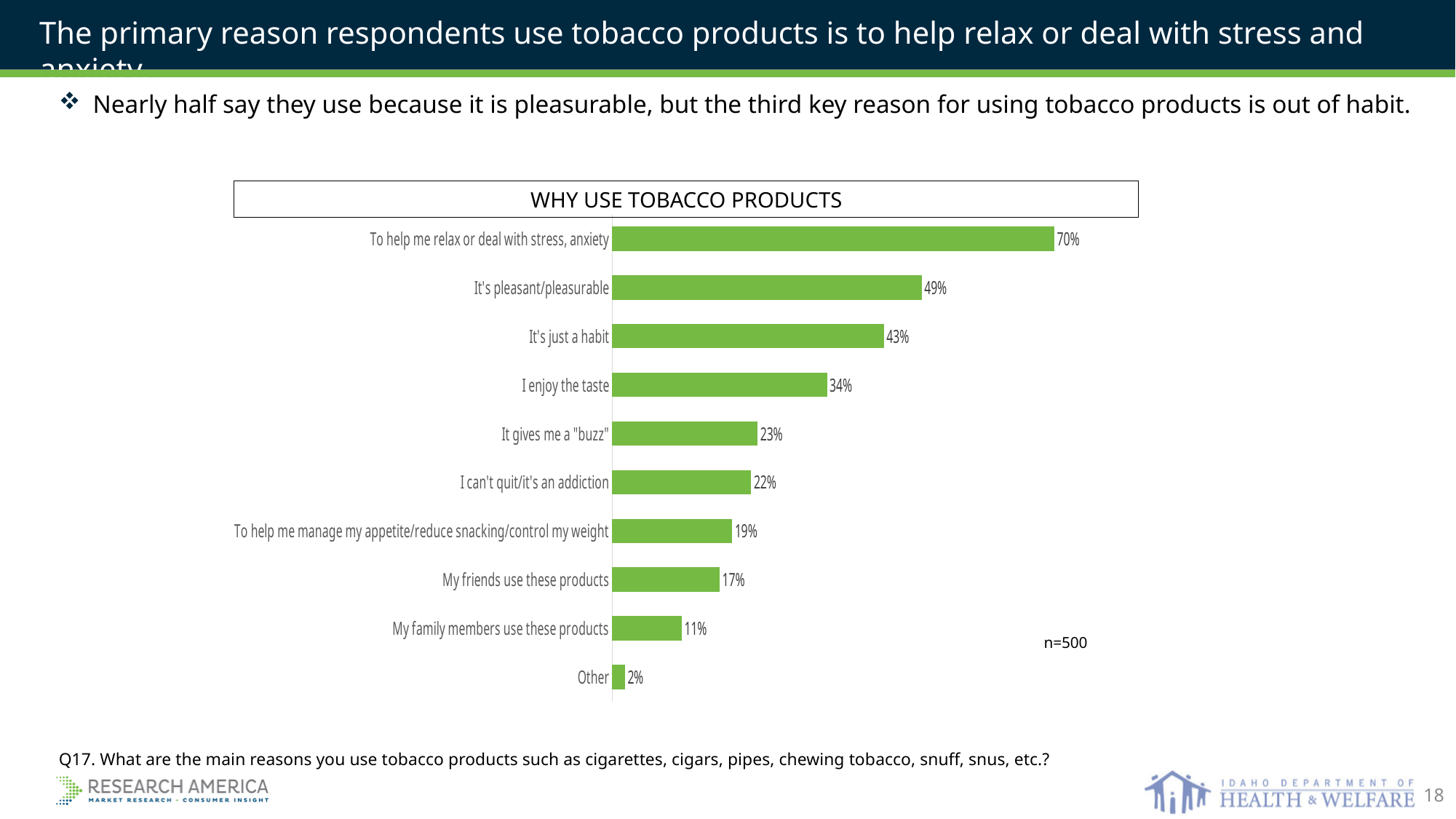
Which has a higher percentage: 'I enjoy the taste' or 'It gives me a "buzz"'? I enjoy the taste What percentage of respondents say they use tobacco products to help them relax or deal with stress, anxiety? 70% What is the difference in percentage points between 'It's pleasant/pleasurable' and 'I enjoy the taste'? 15 What percentage of respondents say they use tobacco products because their family members use these products? 11% Which reason for using tobacco products has the highest percentage? To help me relax or deal with stress, anxiety What percentage of respondents say they use tobacco products because it's just a habit? 43% Which has a higher percentage: 'My friends use these products' or 'My family members use these products'? My friends use these products What is the title of the chart? WHY USE TOBACCO PRODUCTS What is the difference in percentage points between 'To help me relax or deal with stress, anxiety' and 'It's just a habit'? 27 How many reasons for using tobacco products are shown in the chart? 10 What type of chart is used to show why respondents use tobacco products? Bar chart Which reason for using tobacco products has the lowest percentage? Other